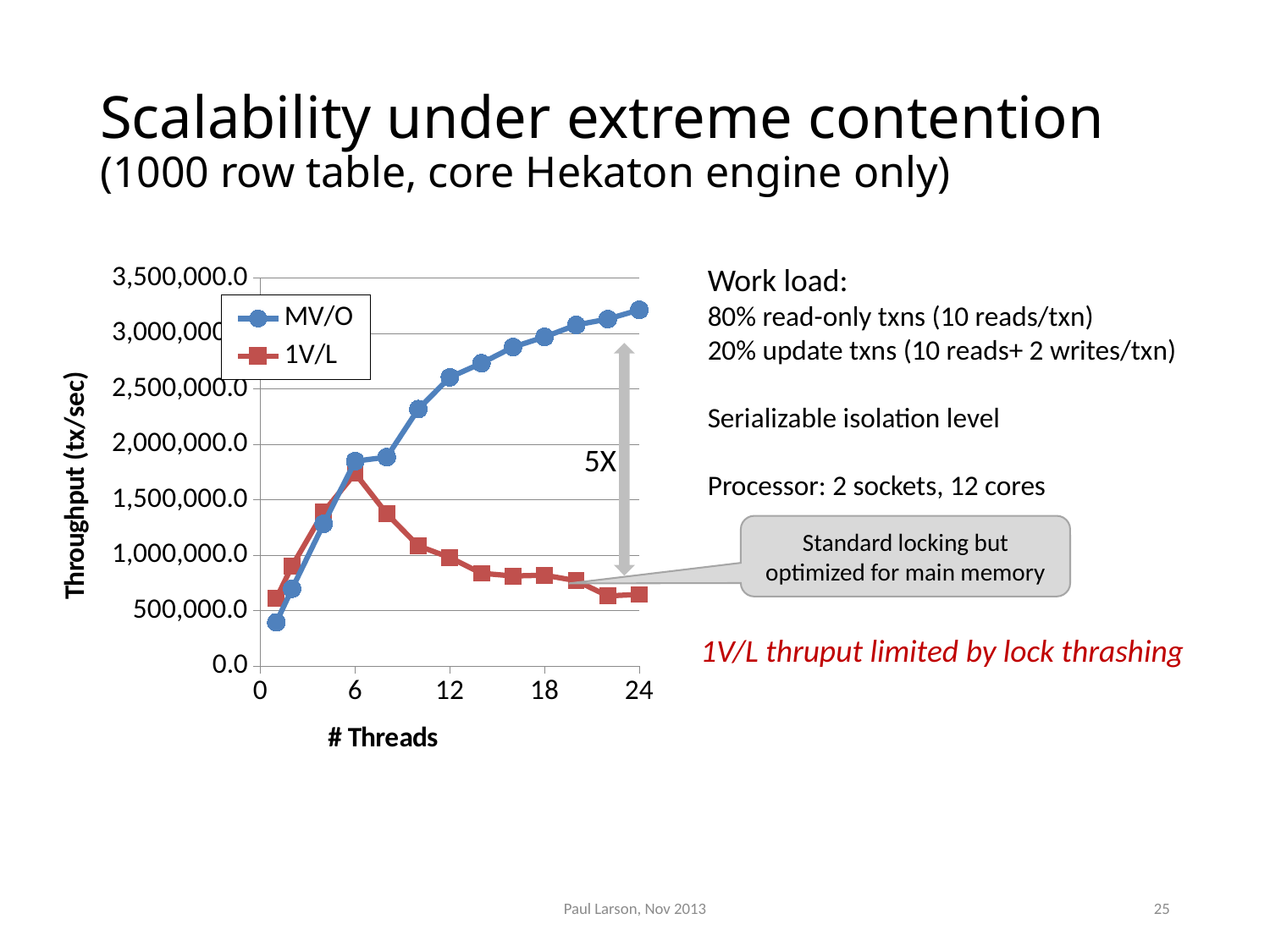
At what number of threads does the 1V/L series reach its highest throughput? 6 Is the 1V/L throughput at 24 threads greater or less than 1,000,000.0? less Is the MV/O throughput at 12 threads greater or less than 2,500,000.0? greater Is the MV/O throughput at 24 threads greater or less than 3,000,000.0? greater How does the MV/O throughput change as the number of threads increases from 1 to 24? It rises How many series does the chart legend list? 2 What type of chart is shown on the slide? line chart What are the two series named in the legend? MV/O and 1V/L What is the label of the y axis? Throughput (tx/sec) At 2 threads, which series has the higher throughput, MV/O or 1V/L? 1V/L At 24 threads, which series has the higher throughput, MV/O or 1V/L? MV/O